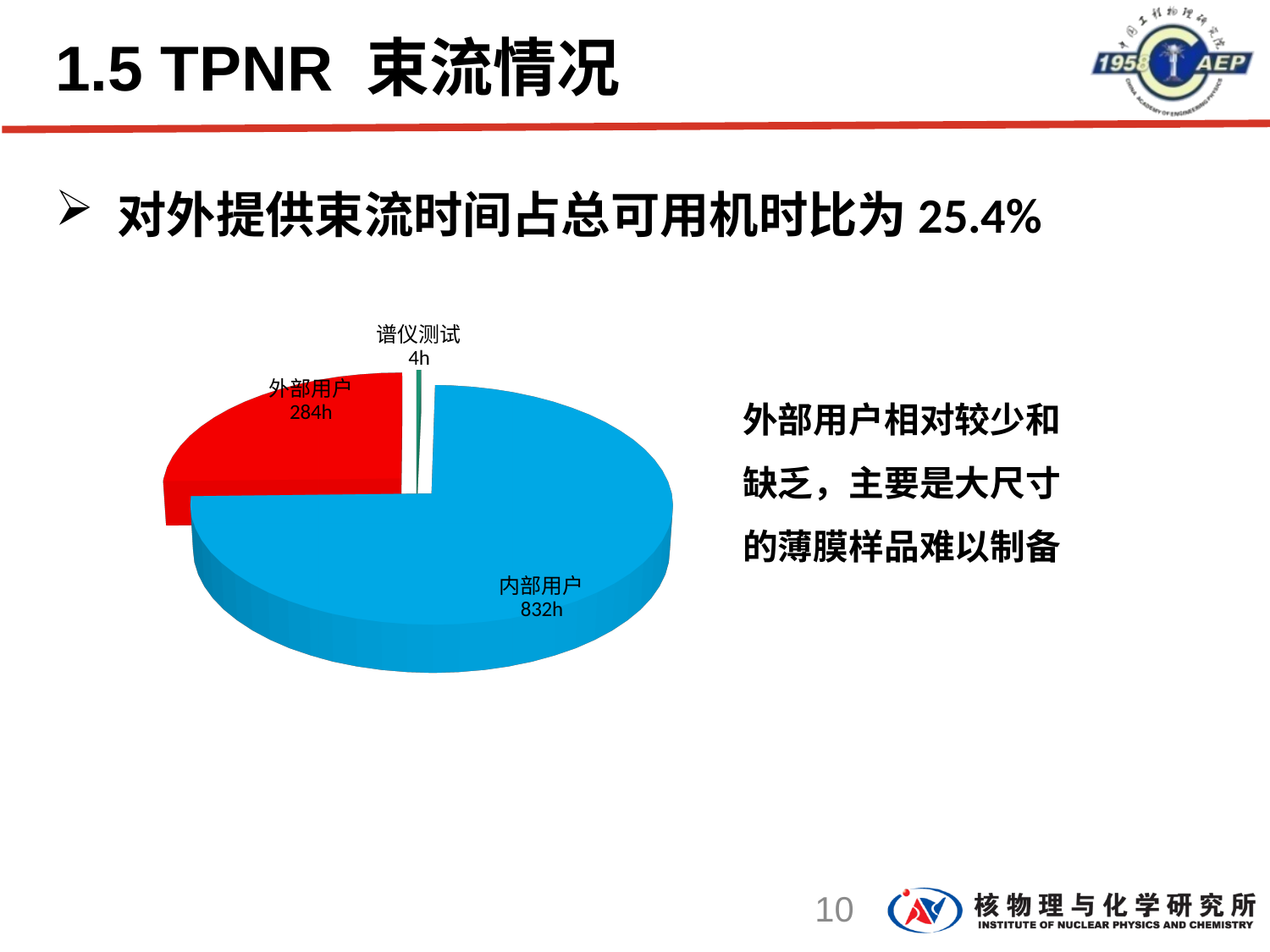
What is the value for 谱仪测试 in the pie chart? 4h What is the value for 内部用户 in the pie chart? 832h What kind of chart is shown on the slide? Pie chart What is the total number of hours across all slices of the pie chart? 1120h What is the value for 外部用户 in the pie chart? 284h Which category has the smallest slice in the pie chart? 谱仪测试 What colour is the 外部用户 slice in the pie chart? Red What is the difference between the hours for 外部用户 and 谱仪测试? 280h Which is larger, the value for 外部用户 or the value for 谱仪测试? 外部用户 Which category has the largest slice in the pie chart? 内部用户 How many slices does the pie chart have? 3 What is the difference between the hours for 内部用户 and 外部用户? 548h